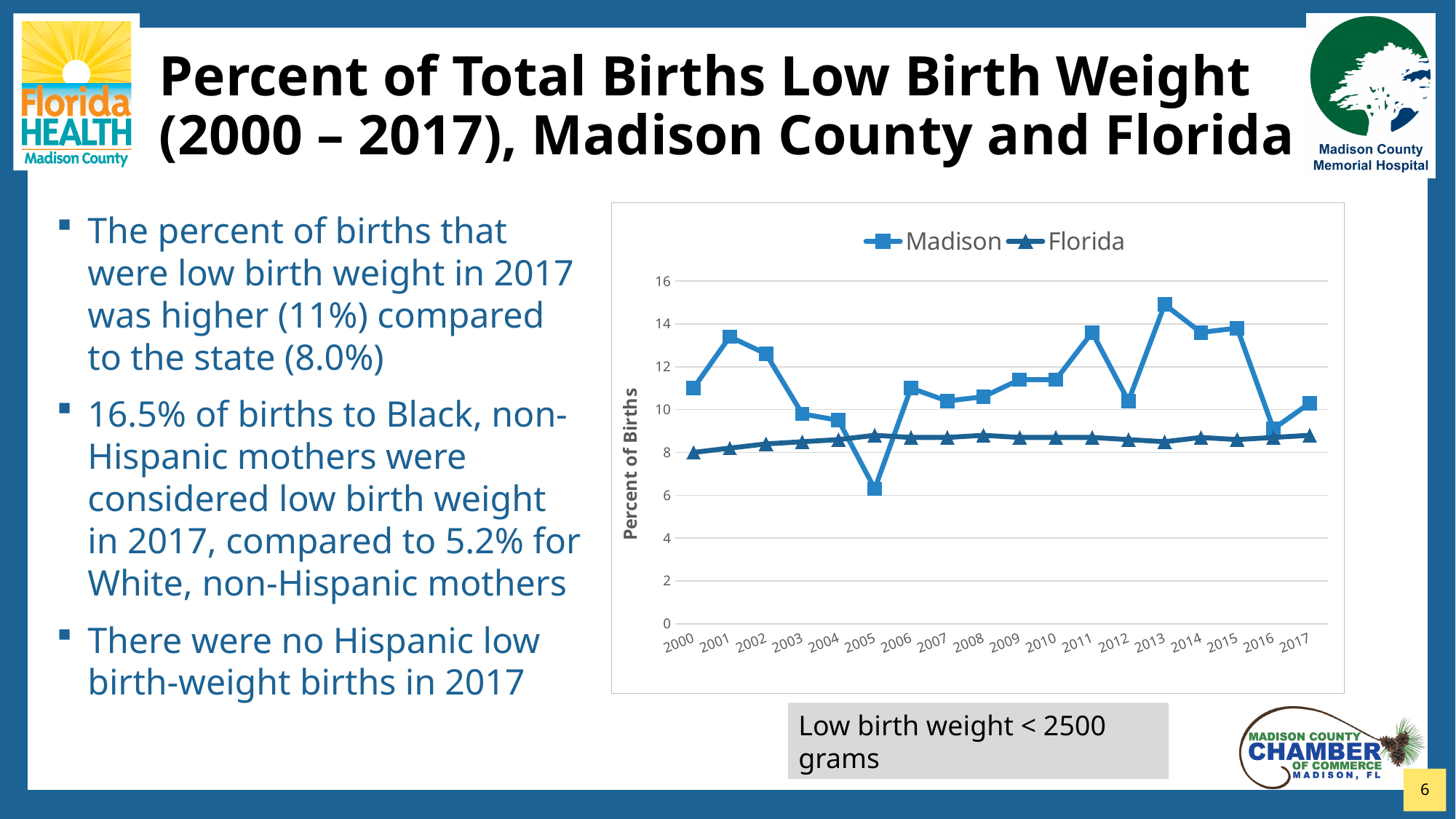
Is the Madison value for 2013 greater or less than 14? greater In which year does the Madison series reach its lowest value? 2005 In which year does the Madison series reach its highest value? 2013 What is the label on the vertical axis of the chart? Percent of Births Is the Florida value for 2017 greater or less than 10? less In 2005, which series has the larger value, Madison or Florida? Florida In 2011, which series has the larger value, Madison or Florida? Madison How many years are plotted along the x axis of the chart? 18 How many series does the chart legend list? 2 Is the Madison value for 2005 greater or less than 8? less What kind of chart is shown on the slide? line chart Which two series are listed in the chart legend? Madison and Florida